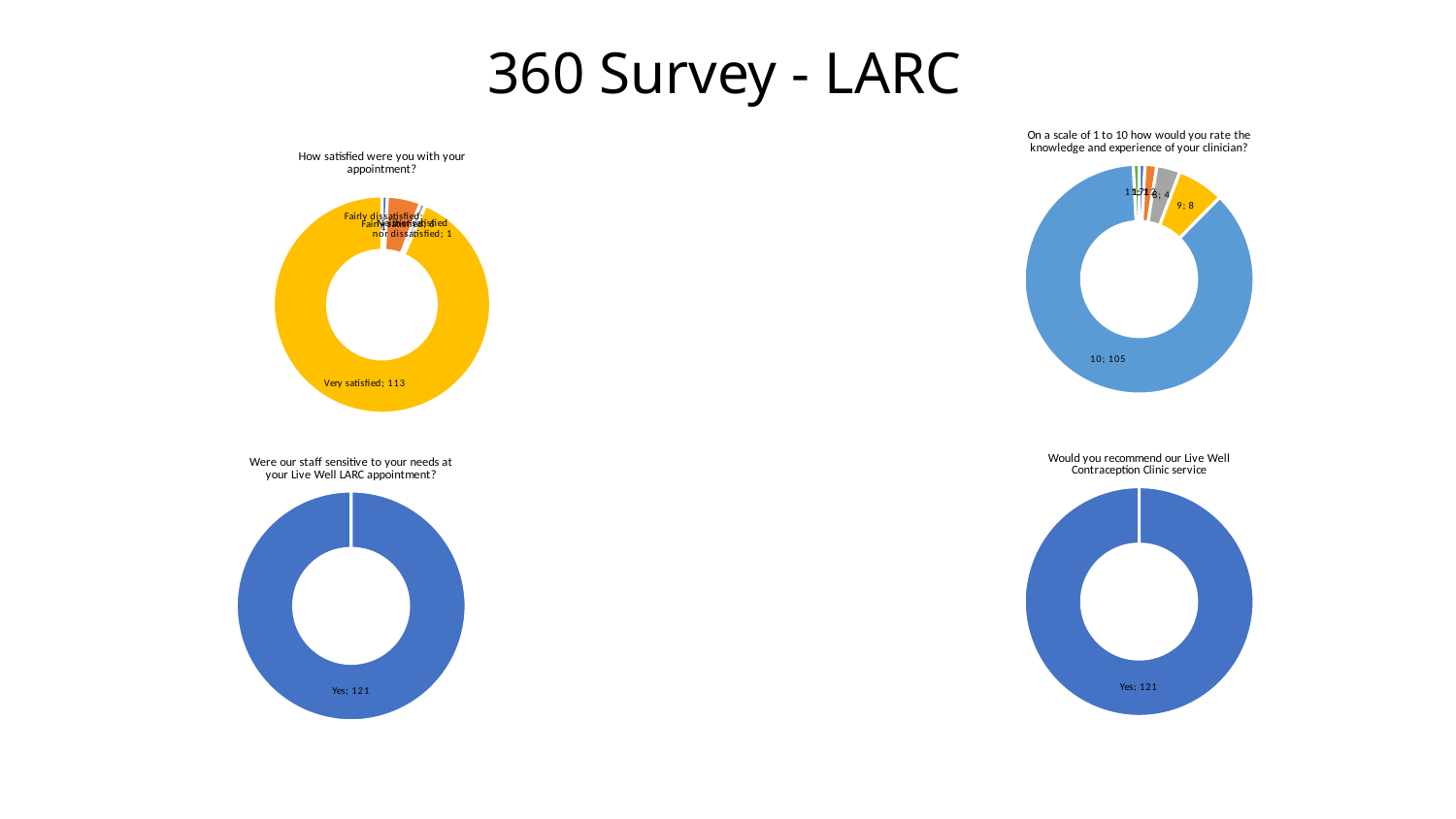
In the chart titled 'Would you recommend our Live Well Contraception Clinic service', how many respondents answered Yes? 121 In the chart titled 'On a scale of 1 to 10 how would you rate the knowledge and experience of your clinician?', how many respondents gave a rating of 9? 8 In the chart titled 'On a scale of 1 to 10 how would you rate the knowledge and experience of your clinician?', which has more respondents: rating 10 or rating 9? 10 In the chart titled 'How satisfied were you with your appointment?', how many respondents were Very satisfied? 113 In the chart titled 'On a scale of 1 to 10 how would you rate the knowledge and experience of your clinician?', which rating has the largest share? 10 In the chart titled 'On a scale of 1 to 10 how would you rate the knowledge and experience of your clinician?', how many respondents gave a rating of 10? 105 What kind of chart is used for 'Were our staff sensitive to your needs at your Live Well LARC appointment?'? Doughnut chart In the chart titled 'Were our staff sensitive to your needs at your Live Well LARC appointment?', how many respondents answered Yes? 121 In the chart titled 'On a scale of 1 to 10 how would you rate the knowledge and experience of your clinician?', how many more respondents gave a rating of 10 than a rating of 9? 97 How many charts are shown on the slide? 4 In the chart titled 'How satisfied were you with your appointment?', which category has the largest share? Very satisfied What is the title of the slide? 360 Survey - LARC